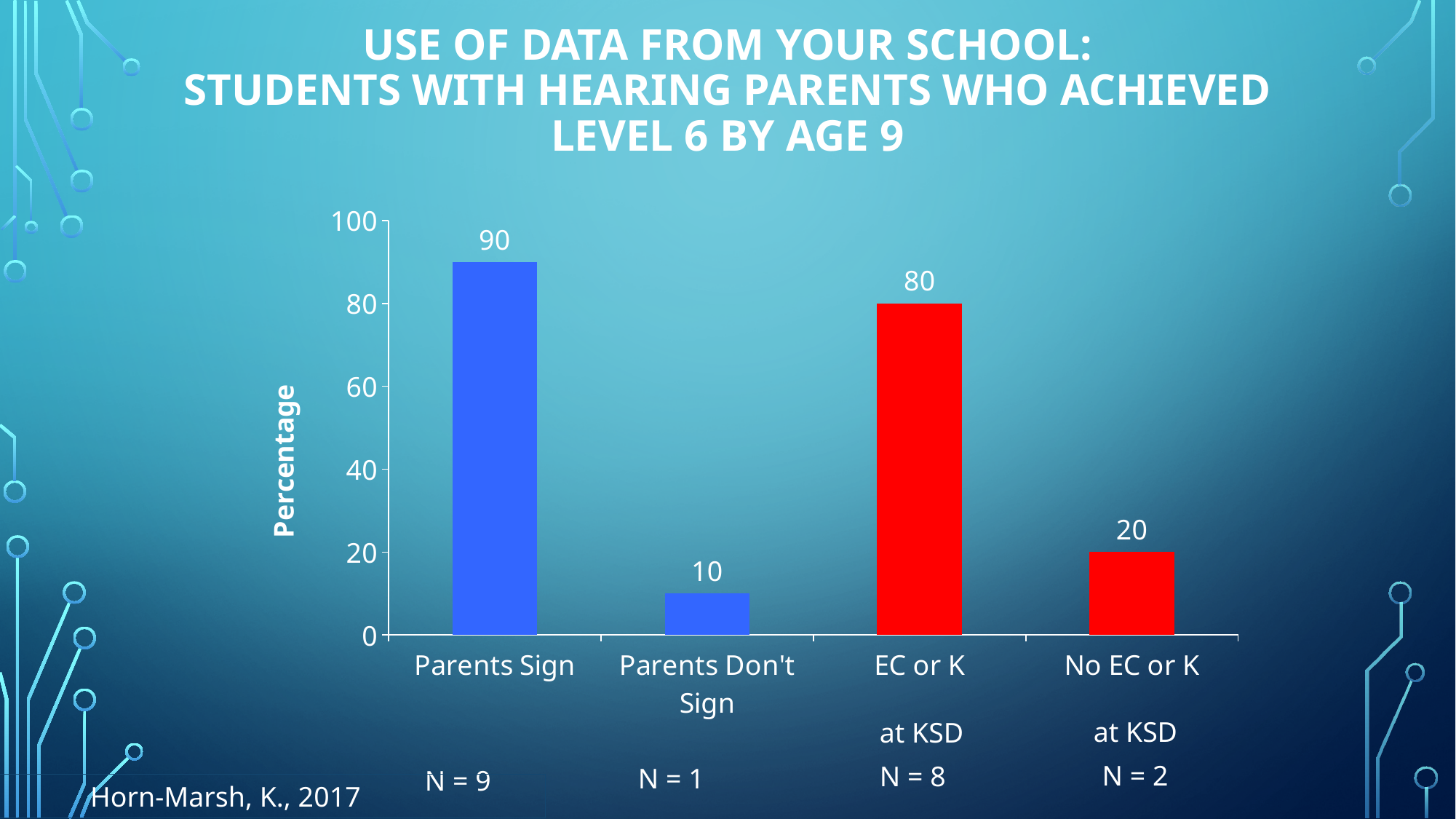
What is the label of the y axis? Percentage How many categories are shown on the x axis? 4 What is the value for EC or K? 80 What kind of chart is this? bar chart What is the difference between the values for Parents Sign and Parents Don't Sign? 80 What is the value for No EC or K? 20 Which category has the highest value? Parents Sign What is the value for Parents Don't Sign? 10 What is the value for Parents Sign? 90 What is the difference between the values for EC or K and No EC or K? 60 Which category has the lowest value? Parents Don't Sign Which is larger, the value for Parents Sign or the value for EC or K? Parents Sign